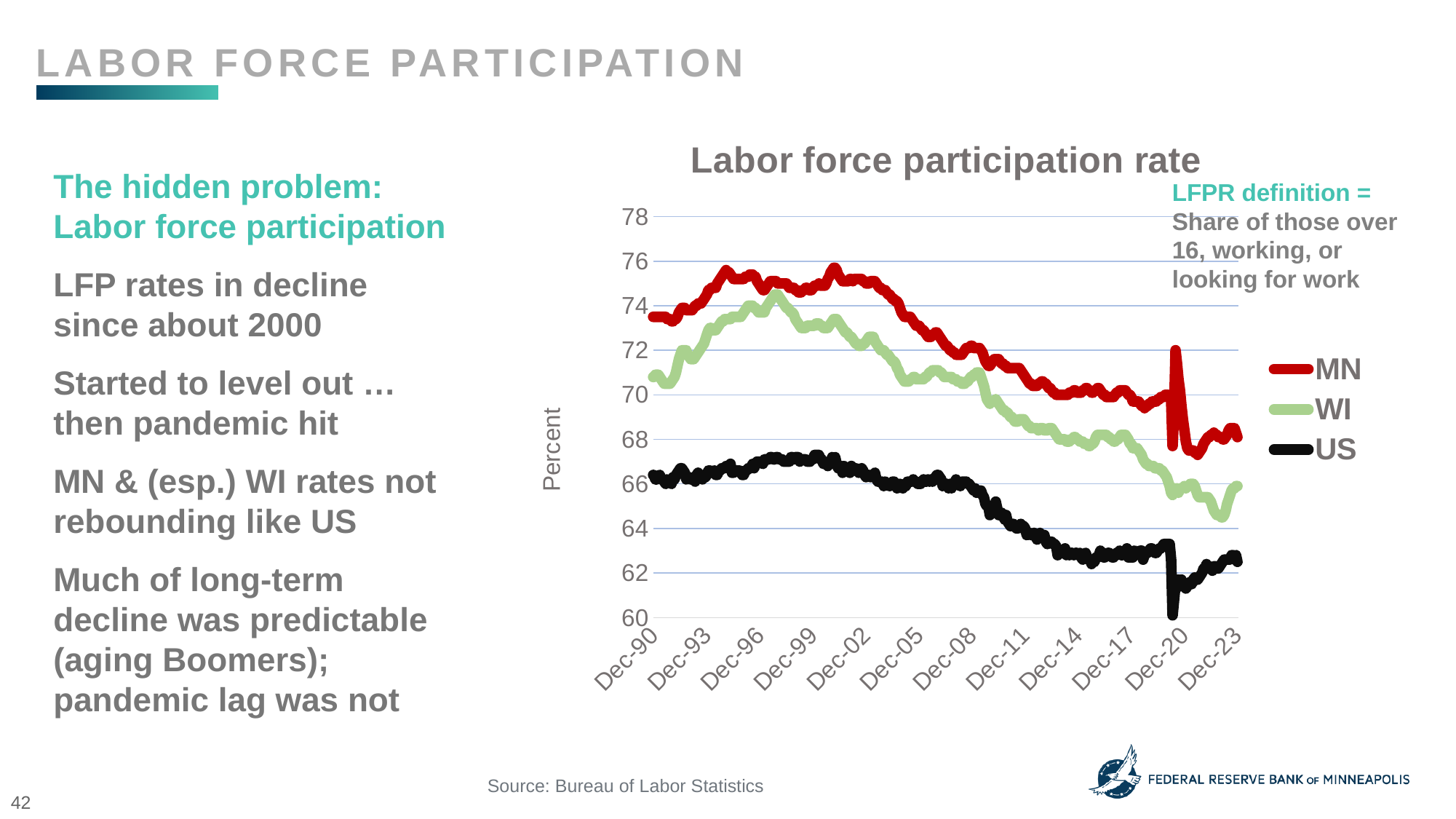
Is the value for MN at Dec-96 greater or less than 74? greater What is the title of the chart? Labor force participation rate Which series has the highest labor force participation rate across the whole period shown? MN At Dec-05, which series has the larger value, WI or US? WI Does the MN line rise or fall between Dec-02 and Dec-17? fall Which series has the lowest labor force participation rate across the whole period shown? US How many series does the legend of the chart list? 3 What kind of chart is shown on the slide? line chart Is the value for US at Dec-14 greater or less than 64? less Is the value for US at Dec-99 greater or less than 68? less What are the three series listed in the chart's legend? MN, WI, US